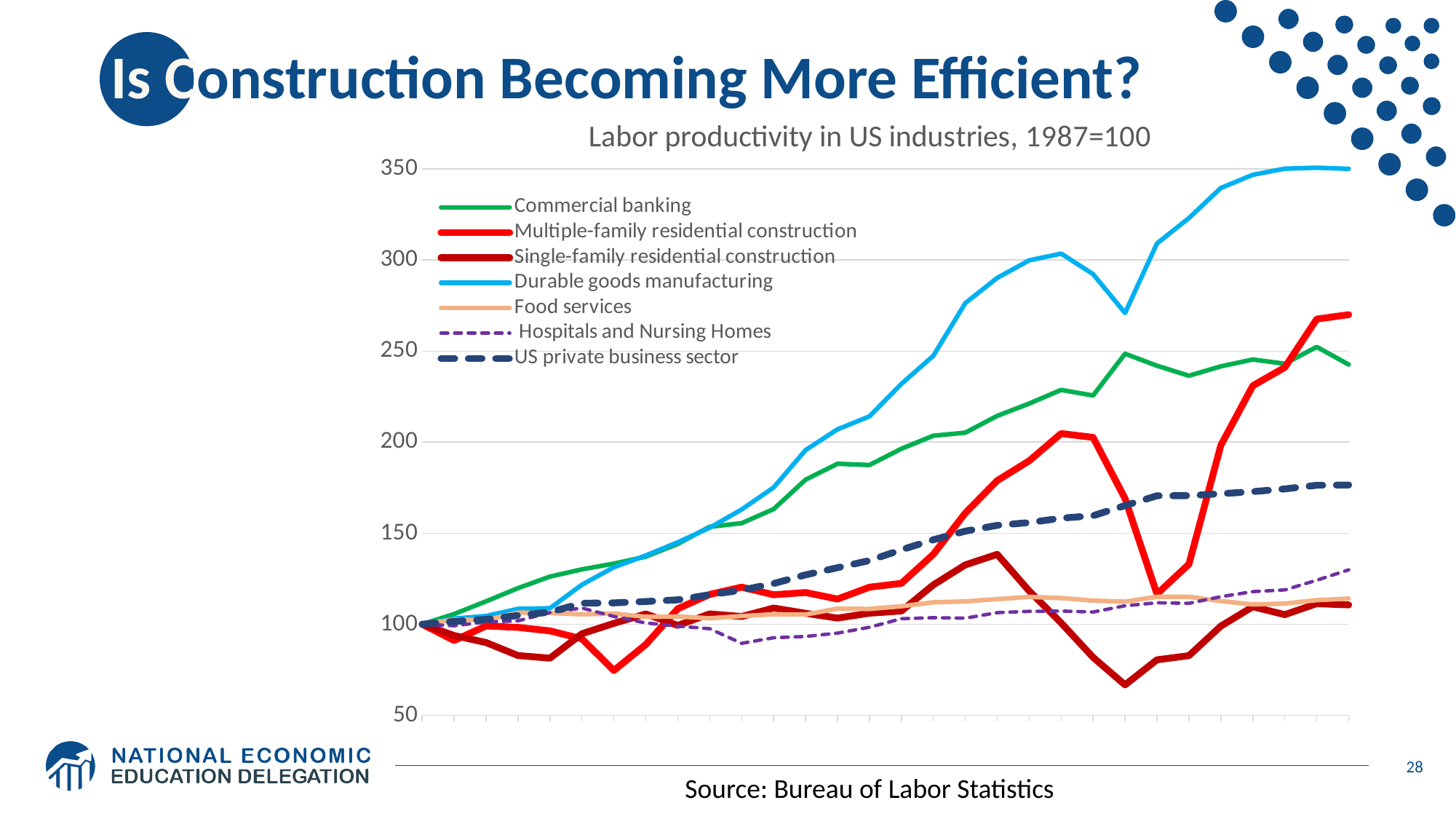
What is the title of the chart? Labor productivity in US industries, 1987=100 What kind of chart is shown on the slide? Line chart At the right end of the chart, which is higher: Hospitals and Nursing Homes or US private business sector? US private business sector Is the final value for Single-family residential construction greater or less than 150? less How many series does the legend list? 7 Is the final value for US private business sector greater or less than 150? greater Is the final value for Multiple-family residential construction greater or less than 250? greater Does the US private business sector line rise or fall across the chart? Rise Which series dips to the lowest value on the chart? Single-family residential construction Which series reaches the highest value on the chart? Durable goods manufacturing At the right end of the chart, which is higher: Commercial banking or Multiple-family residential construction? Multiple-family residential construction